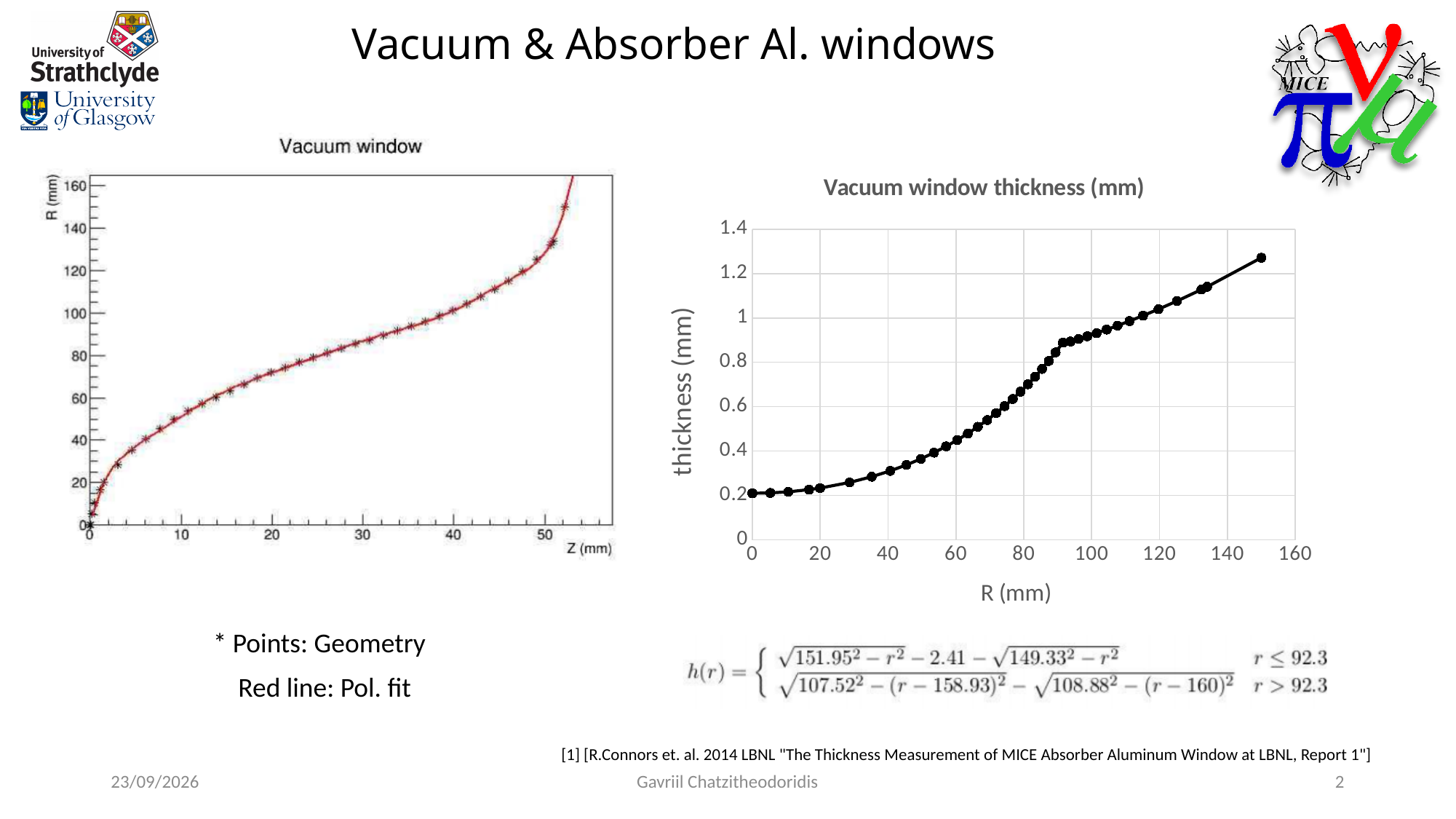
In the 'Vacuum window thickness (mm)' chart, which has the larger thickness: R = 40 mm or R = 140 mm? R = 140 mm In the 'Vacuum window thickness (mm)' chart, is the thickness at R = 100 mm greater or less than 0.8? greater In the 'Vacuum window thickness (mm)' chart, is the thickness at R = 120 mm greater or less than 1.2? less In the 'Vacuum window thickness (mm)' chart, does the thickness rise or fall as R increases? rise What is the title of the chart on the right of the slide? Vacuum window thickness (mm) In the 'Vacuum window thickness (mm)' chart, is the thickness at R = 0 mm greater or less than 0.4? less In the 'Vacuum window' chart on the left, does R rise or fall as Z increases? rise In the 'Vacuum window thickness (mm)' chart, what is the label of the y axis? thickness (mm)